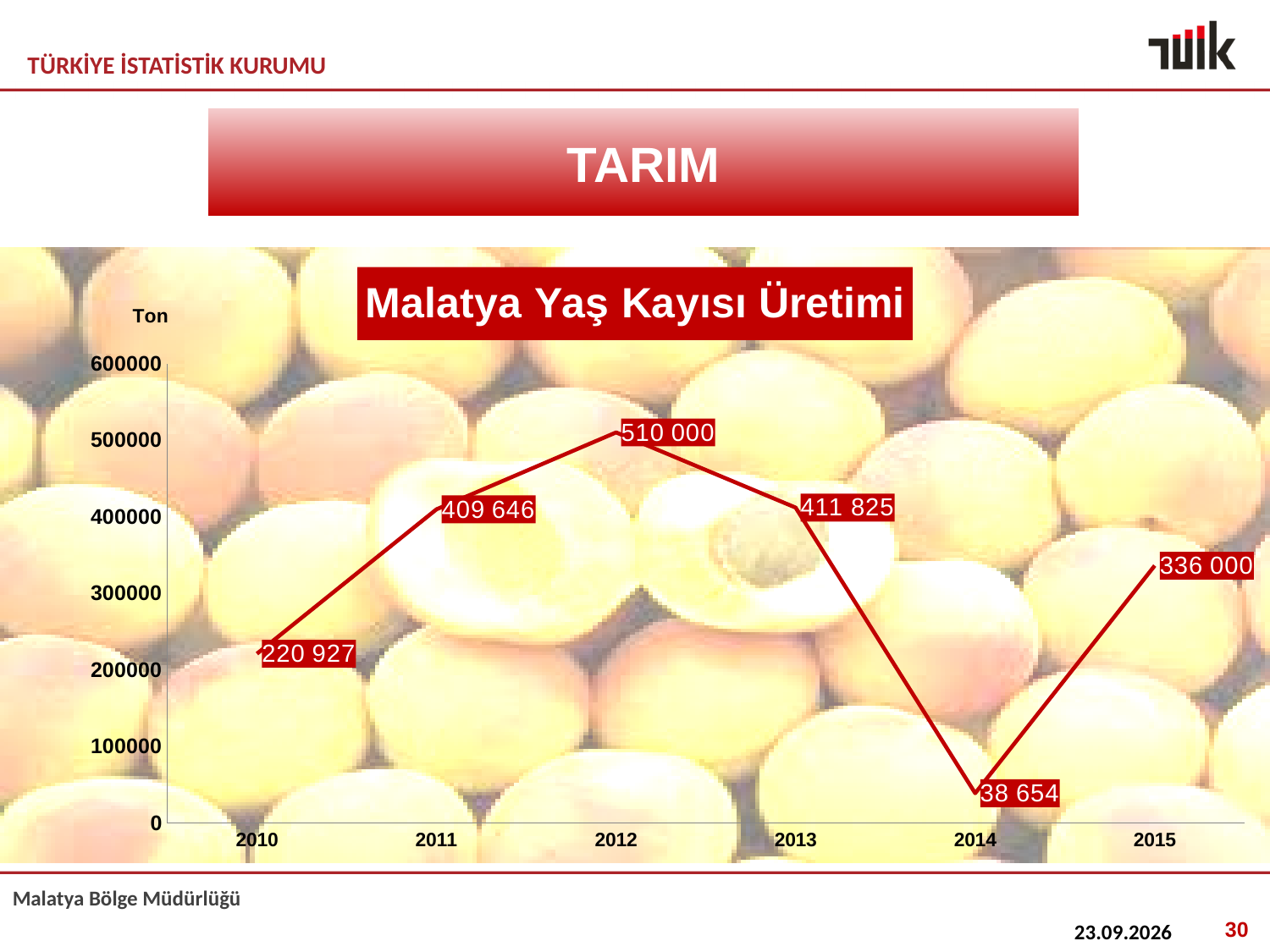
What is the difference between the 2012 and 2011 values? 100 354 Which year has the lowest production? 2014 What is the title of the chart? Malatya Yaş Kayısı Üretimi What kind of chart is shown on the slide? line chart How many years are plotted on the chart? 6 What value is shown for 2012? 510 000 Which year has the highest production? 2012 Is the value for 2013 greater or less than 400000? greater What value is shown for 2014? 38 654 What value is shown for 2015? 336 000 What was Malatya fresh apricot production in 2010? 220 927 What unit is shown on the vertical axis? Ton